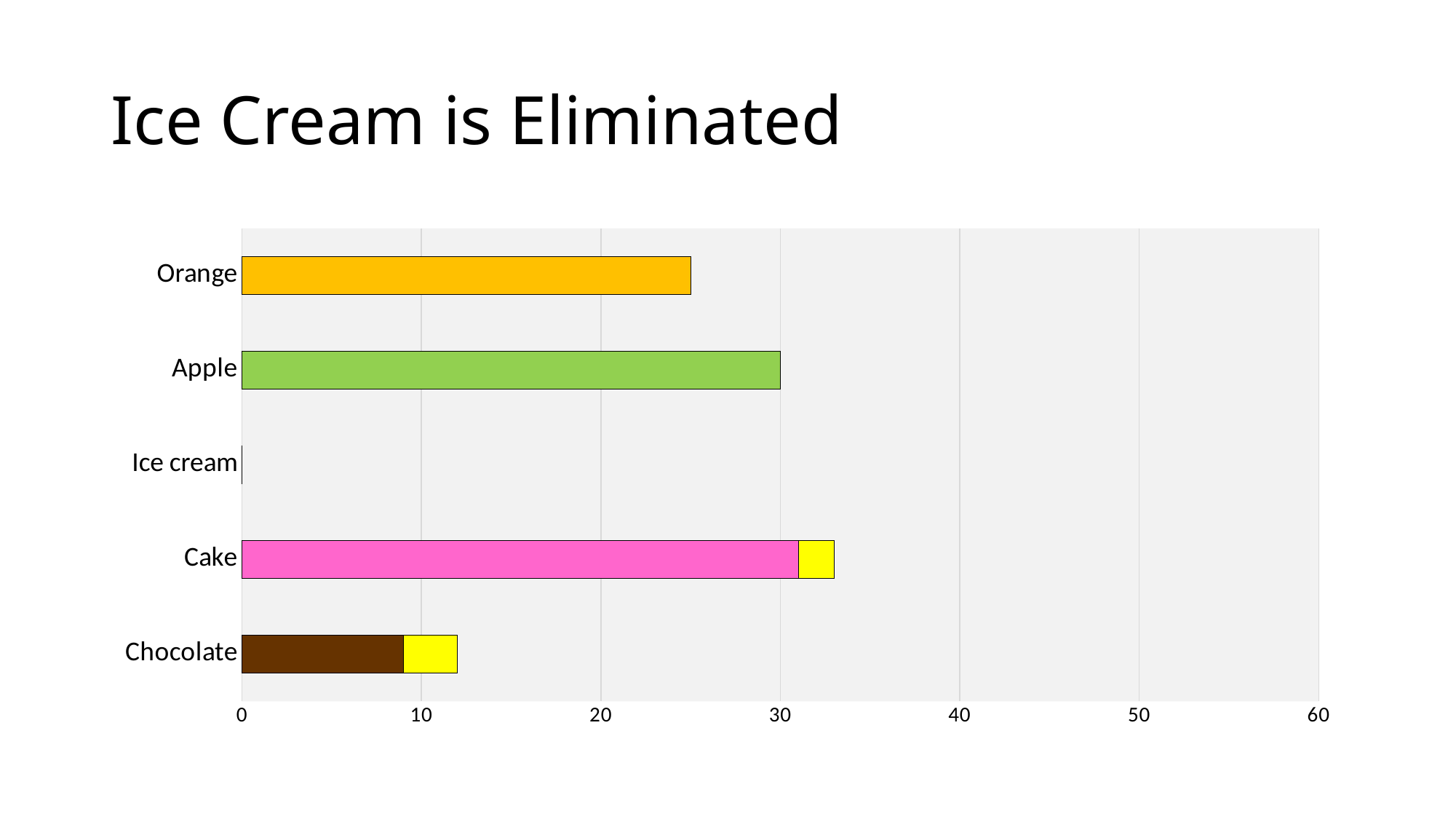
Which category has the lowest value on the chart? Ice cream What is the value for Ice cream? 0 Which category has the highest value on the chart? Cake What kind of chart is shown on the slide? bar chart Which is larger, the value for Chocolate or the value for Cake? Cake How many categories are shown on the chart? 5 Is the value for Chocolate greater or less than 10? greater What is the value for Apple? 30 Which is larger, the value for Orange or the value for Apple? Apple Is the value for Orange greater or less than 30? less Is the value for Cake greater or less than 30? greater What is the title of the slide? Ice Cream is Eliminated